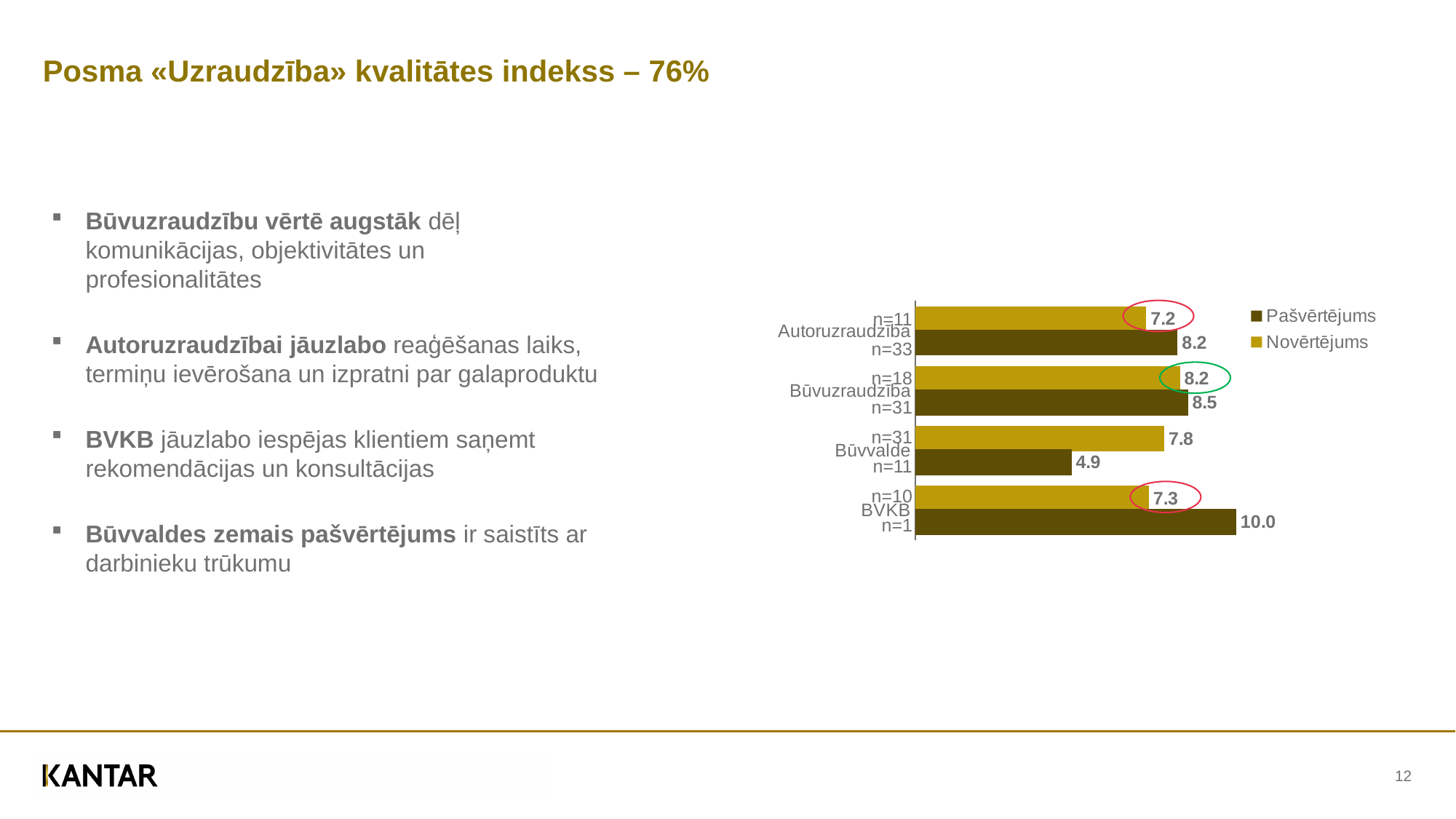
Which category has the lowest Novērtējums value? Autoruzraudzība What is the difference between the Pašvērtējums and Novērtējums values for BVKB? 2.7 How many categories are shown in the chart? 4 What is the Pašvērtējums value for Būvvalde? 4.9 Which category has the highest Pašvērtējums value? BVKB What kind of chart is shown on the slide? Bar chart How many series does the legend list? 2 For Būvvalde, which is larger: the Pašvērtējums or the Novērtējums value? Novērtējums What are the two series named in the legend? Pašvērtējums and Novērtējums What is the Novērtējums value for Būvuzraudzība? 8.2 What is the Pašvērtējums value for BVKB? 10.0 What is the Novērtējums value for Autoruzraudzība? 7.2